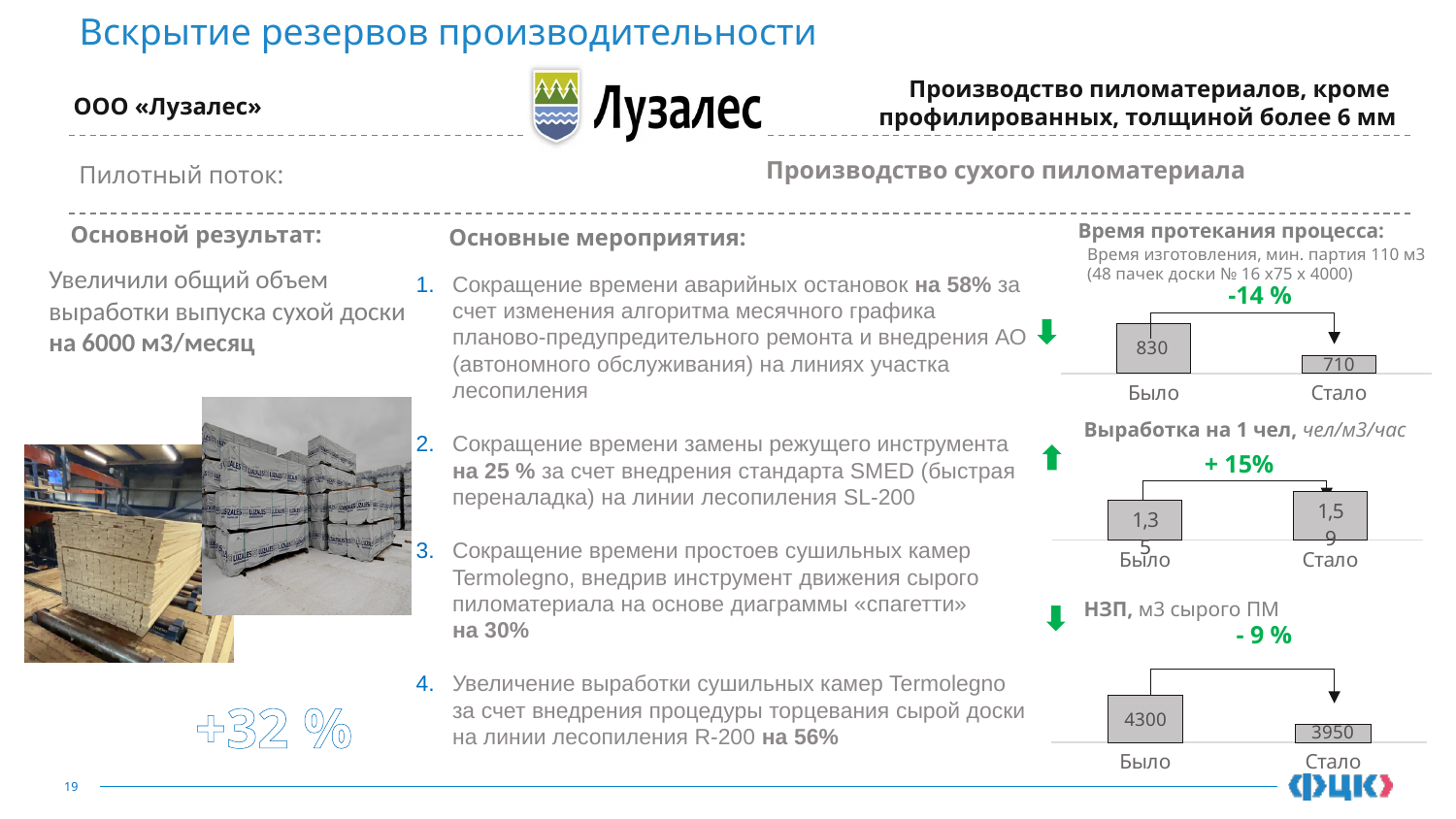
In the 'НЗП' chart, what is the value for 'Было'? 4300 In the 'НЗП' chart, which category has the higher value, 'Было' or 'Стало'? Было How many categories does the 'Время протекания процесса' chart show? 2 In the 'Время протекания процесса' chart, what is the value for 'Было'? 830 In the 'Время протекания процесса' chart, what percentage change is shown above the bars? -14 % What type of chart is the 'НЗП' chart? Bar chart In the 'НЗП' chart, what is the value for 'Стало'? 3950 In the 'Время протекания процесса' chart, what is the difference between 'Было' and 'Стало'? 120 In the 'Выработка на 1 чел' chart, which category has the higher value, 'Было' or 'Стало'? Стало In the 'НЗП' chart, what is the difference between 'Было' and 'Стало'? 350 In the 'Выработка на 1 чел' chart, what percentage change is shown above the bars? + 15% In the 'Время протекания процесса' chart, what is the value for 'Стало'? 710